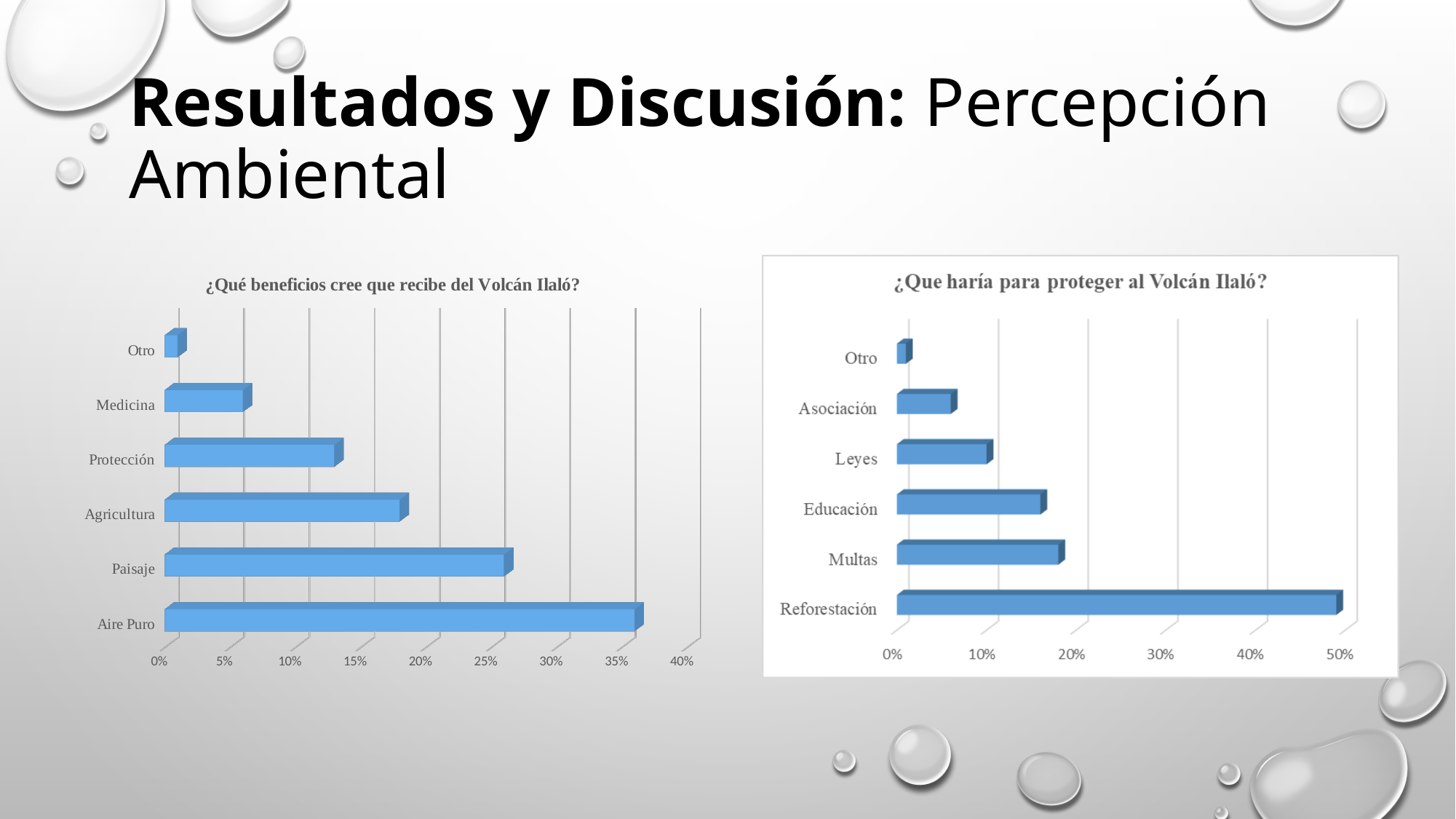
What kind of chart is the left chart titled "¿Qué beneficios cree que recibe del Volcán Ilaló?"? bar chart In the left chart "¿Qué beneficios cree que recibe del Volcán Ilaló?", which category has the lowest value? Otro In the left chart "¿Qué beneficios cree que recibe del Volcán Ilaló?", which category has the highest value? Aire Puro In the left chart "¿Qué beneficios cree que recibe del Volcán Ilaló?", how many categories are shown? 6 In the right chart "¿Que haría para proteger al Volcán Ilaló?", is the value for Reforestación greater or less than 40%? greater In the left chart "¿Qué beneficios cree que recibe del Volcán Ilaló?", is the value for Aire Puro greater or less than 30%? greater In the right chart "¿Que haría para proteger al Volcán Ilaló?", which is larger, Educación or Leyes? Educación In the right chart "¿Que haría para proteger al Volcán Ilaló?", is the value for Asociación greater or less than 10%? less In the right chart "¿Que haría para proteger al Volcán Ilaló?", which category has the lowest value? Otro In the right chart "¿Que haría para proteger al Volcán Ilaló?", which category has the highest value? Reforestación In the left chart "¿Qué beneficios cree que recibe del Volcán Ilaló?", which is larger, Paisaje or Agricultura? Paisaje